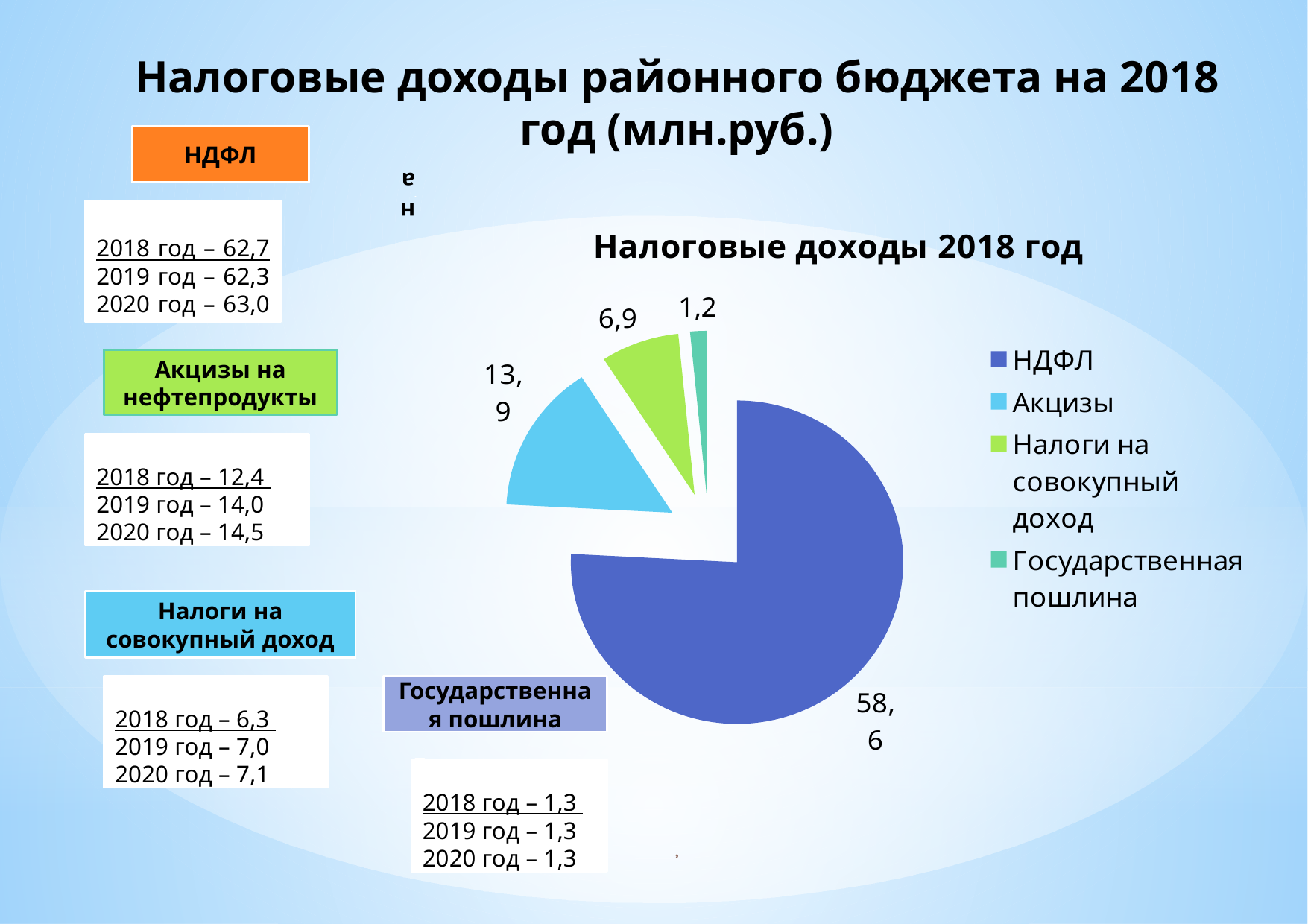
Which category has the smallest slice in the pie chart? Государственная пошлина What is the value of the Акцизы slice in the pie chart? 13,9 What is the value of the Государственная пошлина slice in the pie chart? 1,2 Which is larger in the pie chart: Акцизы or Налоги на совокупный доход? Акцизы What is the difference between the Акцизы and Налоги на совокупный доход values in the pie chart? 7,0 What is the difference between the НДФЛ and Акцизы values in the pie chart? 44,7 What type of chart is shown on the slide? Pie chart What is the value of the НДФЛ slice in the pie chart? 58,6 What is the value of the Налоги на совокупный доход slice in the pie chart? 6,9 Which category has the largest slice in the pie chart? НДФЛ What is the title of the chart on the slide? Налоговые доходы 2018 год How many slices does the pie chart have? 4